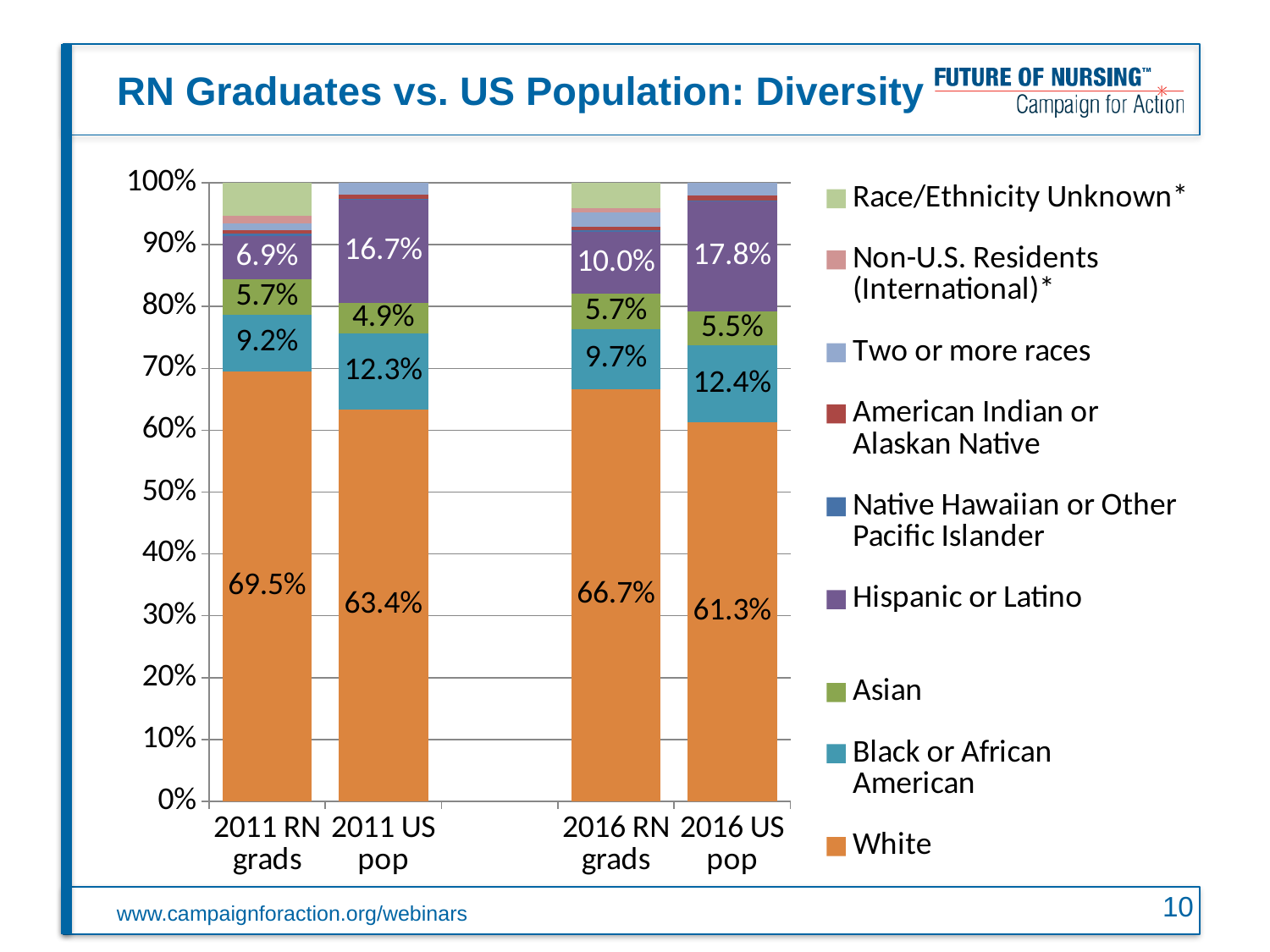
Which category has the lowest Hispanic or Latino share? 2011 RN grads Which is larger, the Hispanic or Latino share for 2016 RN grads or for 2016 US pop? 2016 US pop What is the Hispanic or Latino share for 2016 US pop? 17.8% What is the difference between the White share for 2011 RN grads and 2011 US pop? 6.1% What is the title of the slide? RN Graduates vs. US Population: Diversity What is the Black or African American share for 2011 US pop? 12.3% How many categories are shown on the x axis? 4 What kind of chart is shown on the slide? Stacked bar chart How many series does the legend list? 9 What is the White share for 2011 RN grads? 69.5% What is the Asian share for 2016 RN grads? 5.7% Which category has the highest White share? 2011 RN grads